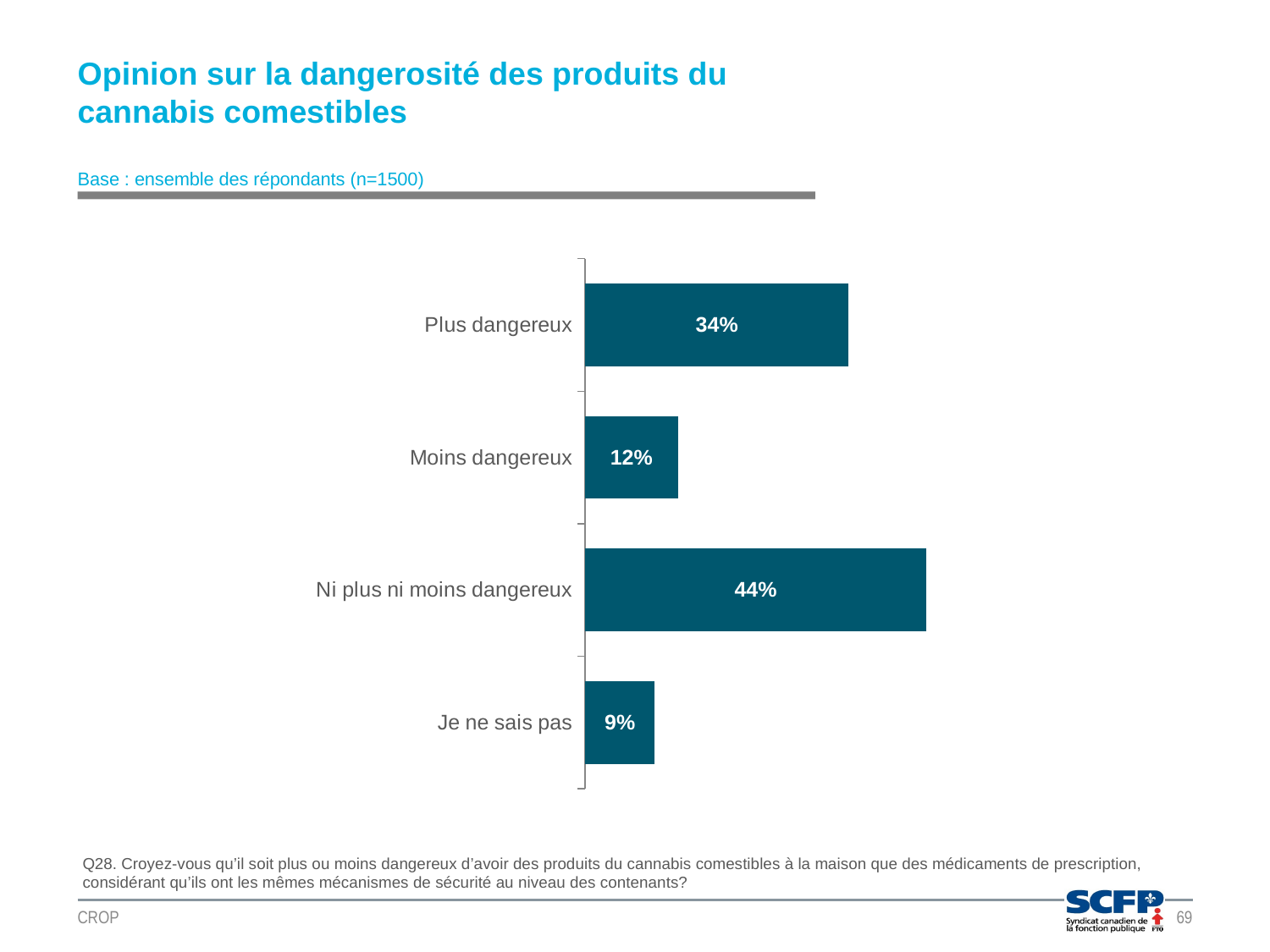
What is the value for "Plus dangereux"? 34% What kind of chart is shown on the slide? Bar chart What is the value for "Moins dangereux"? 12% What is the base (n) stated for the chart? n=1500 How many categories are shown in the chart? 4 Which category has the highest value? Ni plus ni moins dangereux Which category has the lowest value? Je ne sais pas What is the difference between the values for "Ni plus ni moins dangereux" and "Plus dangereux"? 10% What is the difference between the values for "Moins dangereux" and "Je ne sais pas"? 3% Which is larger, the value for "Plus dangereux" or the value for "Moins dangereux"? Plus dangereux What is the value for "Je ne sais pas"? 9% What is the value for "Ni plus ni moins dangereux"? 44%